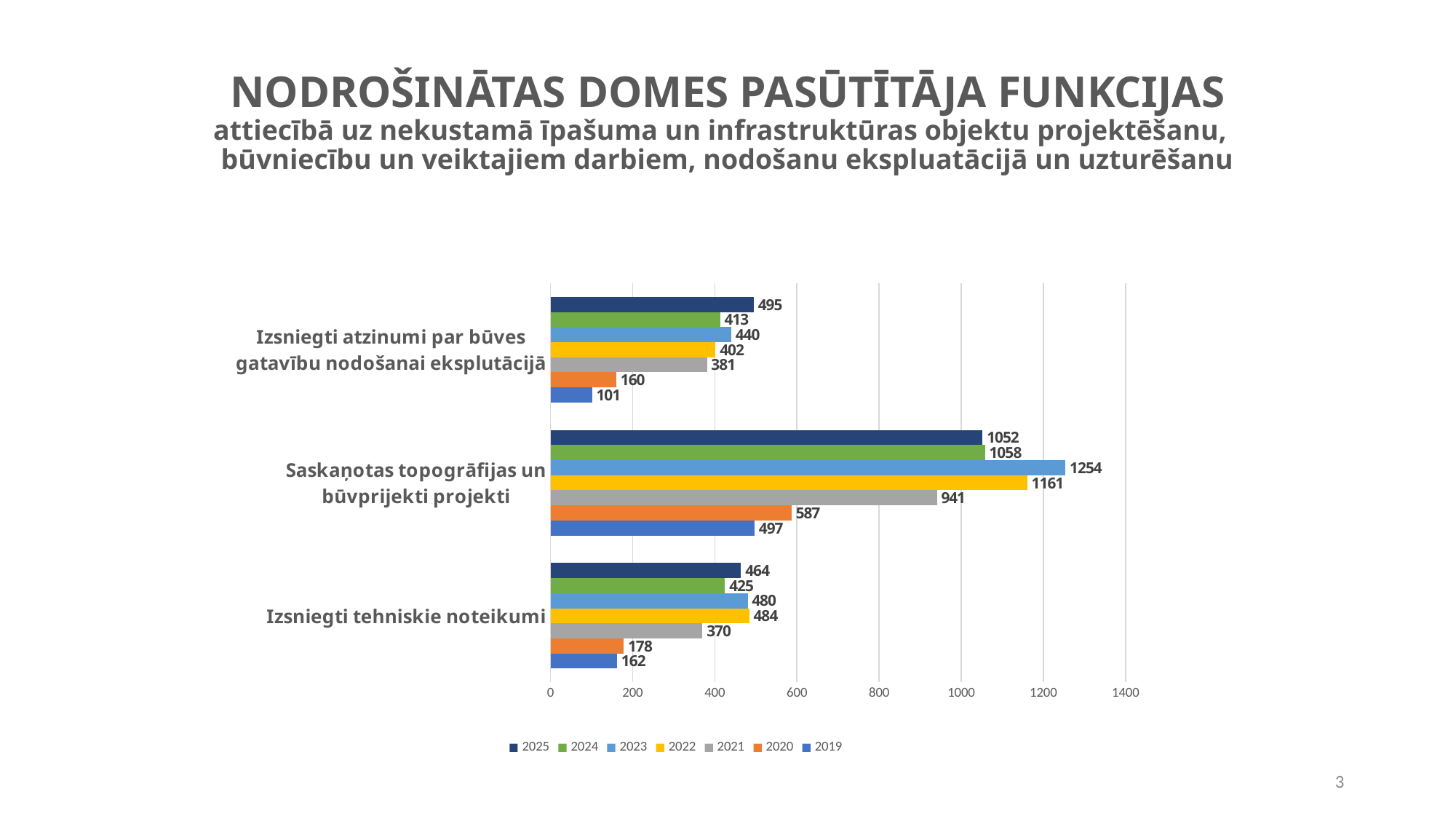
How many series does the legend list? 7 What is the value for 2019 in the category "Izsniegti tehniskie noteikumi"? 162 What is the difference between the 2025 and 2024 values in the category "Izsniegti tehniskie noteikumi"? 39 Which year has the lowest value in the category "Izsniegti atzinumi par būves gatavību nodošanai eksplutācijā"? 2019 Is the value for 2021 in the category "Saskaņotas topogrāfijas un būvprijekti projekti" greater or less than 800? greater In the category "Saskaņotas topogrāfijas un būvprijekti projekti", which is larger: the value for 2022 or the value for 2021? 2022 What is the value for 2023 in the category "Saskaņotas topogrāfijas un būvprijekti projekti"? 1254 What is the value for 2025 in the category "Izsniegti atzinumi par būves gatavību nodošanai eksplutācijā"? 495 What kind of chart is shown on the slide? bar chart What is the difference between the 2020 and 2019 values in the category "Izsniegti atzinumi par būves gatavību nodošanai eksplutācijā"? 59 Which year has the highest value in the category "Saskaņotas topogrāfijas un būvprijekti projekti"? 2023 How many categories are shown on the chart? 3